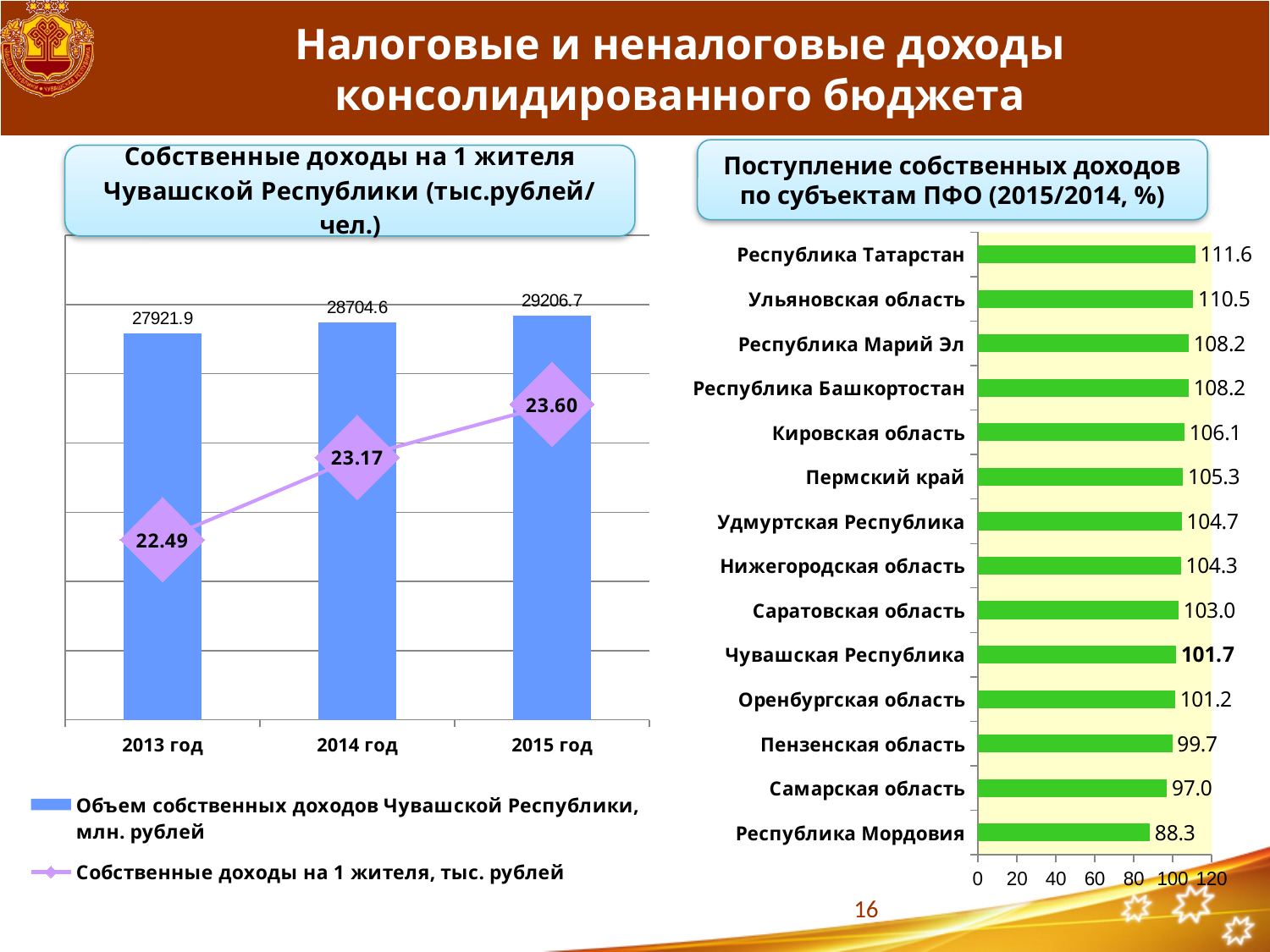
In the right chart, what is the value for Чувашская Республика? 101.7 In the left chart (Собственные доходы на 1 жителя Чувашской Республики), what is the value of the bar for 2014 год? 28704.6 In the right chart, what is the difference between the values for Республика Татарстан and Республика Мордовия? 23.3 In the left chart, what is the difference between the bar values for 2015 год and 2013 год? 1284.8 In the right chart, how many regions are shown? 14 What kind of chart is the right chart? bar chart In the left chart, do the bar values rise or fall from 2013 год to 2015 год? rise In the right chart, which is larger: the value for Пермский край or the value for Самарская область? Пермский край In the left chart, how many series does the legend list? 2 In the right chart, which region has the lowest value? Республика Мордовия In the right chart (Поступление собственных доходов по субъектам ПФО), which region has the highest value? Республика Татарстан In the left chart, what is the value of the line series (Собственные доходы на 1 жителя, тыс. рублей) for 2013 год? 22.49